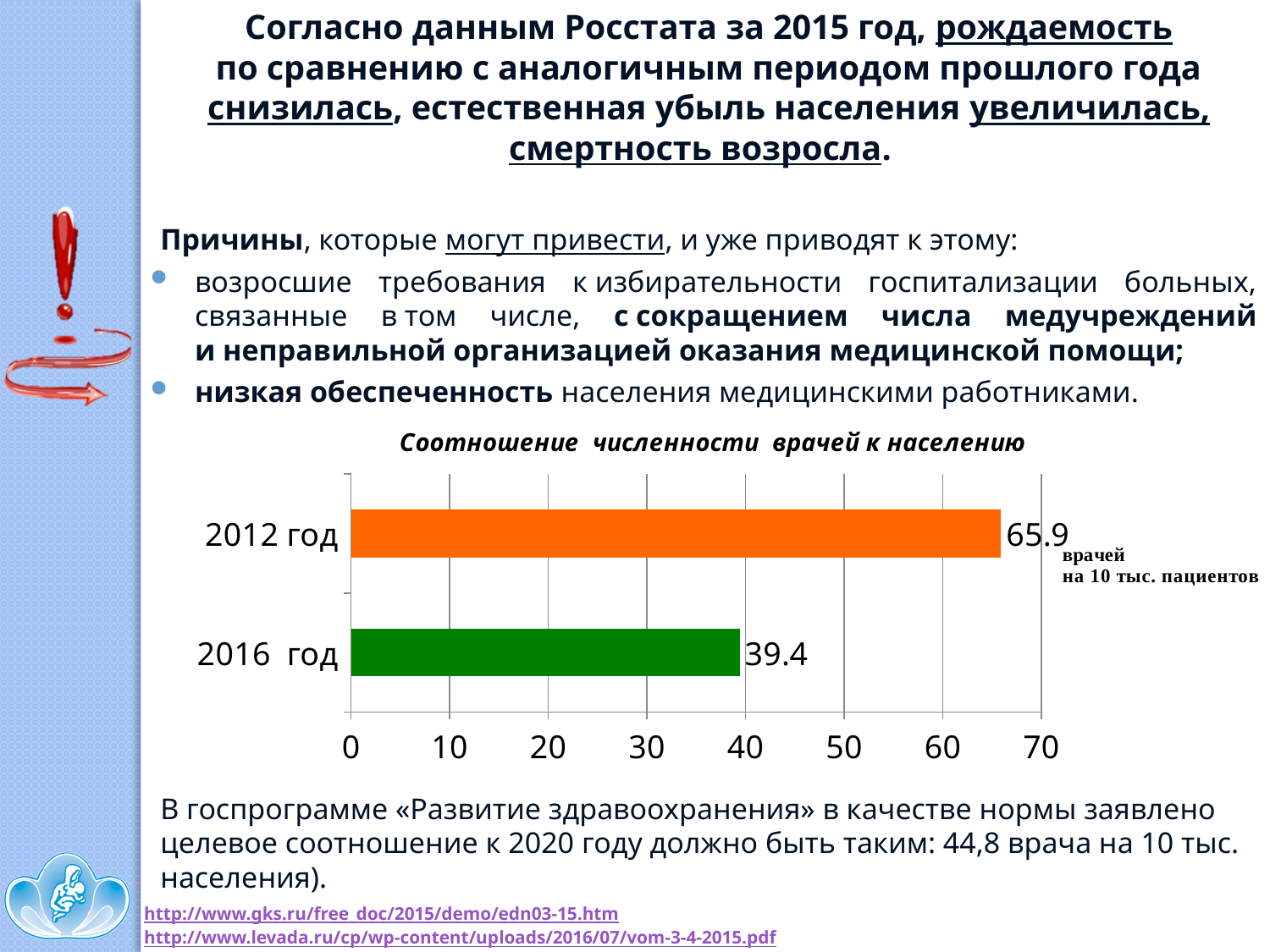
Is the value for 2012 год larger or smaller than the value for 2016 год? larger Which year has the higher value in the chart? 2012 год What is the value for 2012 год in the chart? 65.9 Is the value for 2012 год greater or less than 60? greater Which year has the lower value in the chart? 2016 год What is the value for 2016 год in the chart? 39.4 Is the value for 2016 год greater or less than 40? less What is the maximum value shown on the horizontal axis of the chart? 70 How many categories (bars) are shown in the chart? 2 What kind of chart is shown on the slide? bar chart What is the title of the chart? Соотношение численности врачей к населению What is the difference between the values for 2012 год and 2016 год? 26.5